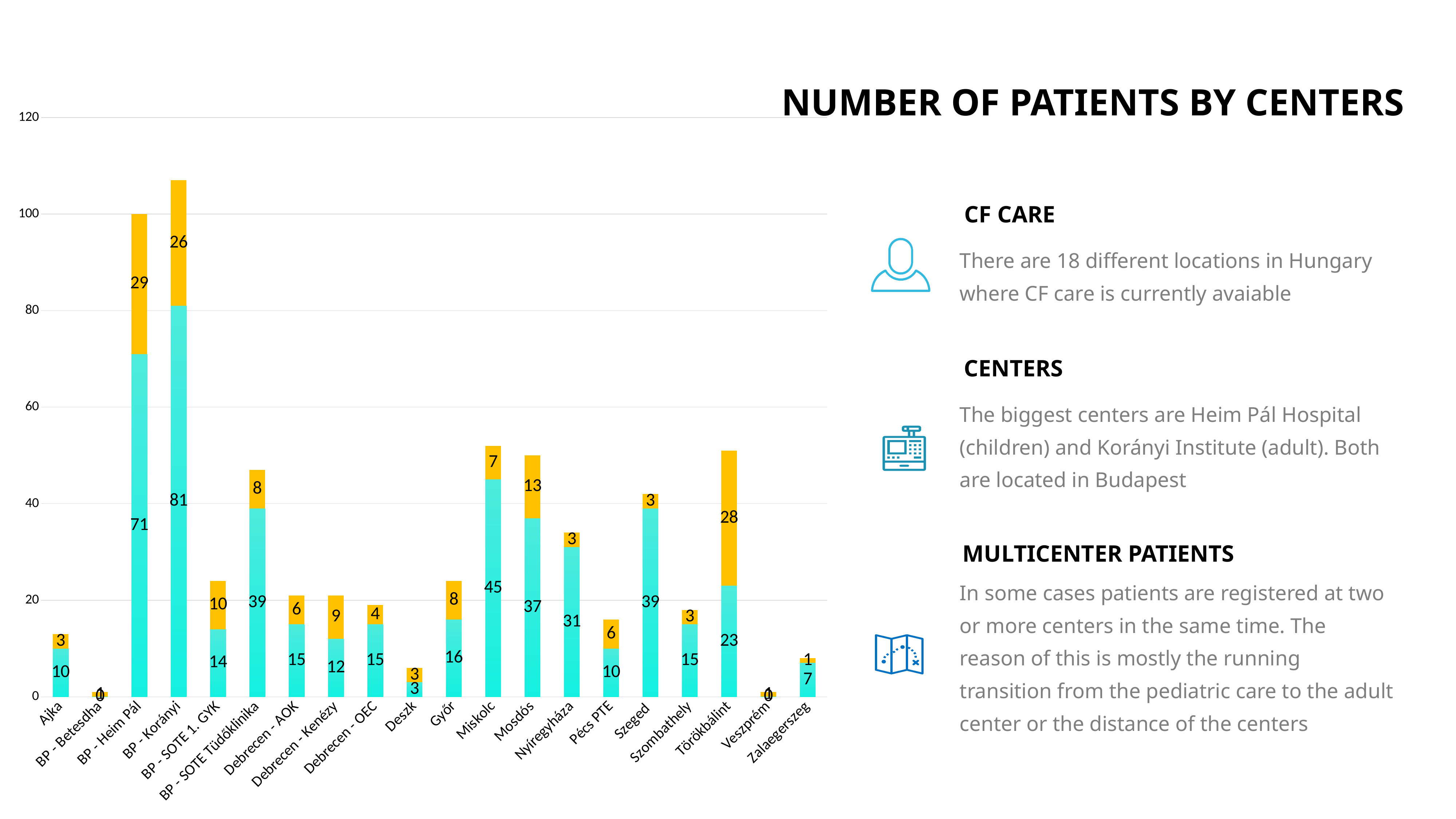
What type of chart is shown on the slide? Stacked bar chart What is the total of the stacked bar for BP - Heim Pál? 100 How many centers (categories) are shown on the x axis of the chart? 20 What is the difference between the cyan segment values of BP - Korányi and BP - Heim Pál? 10 What is the value of the cyan (lower) segment for Miskolc? 45 Which is larger, the cyan segment for Mosdós or the cyan segment for Nyíregyháza? Mosdós What is the title of the chart? NUMBER OF PATIENTS BY CENTERS What is the value of the cyan (lower) segment for BP - Korányi? 81 What is the value of the orange (upper) segment for Törökbálint? 28 What is the value of the orange (upper) segment for BP - Heim Pál? 29 What is the total of the stacked bar for Törökbálint? 51 Which center has the tallest stacked bar overall? BP - Korányi